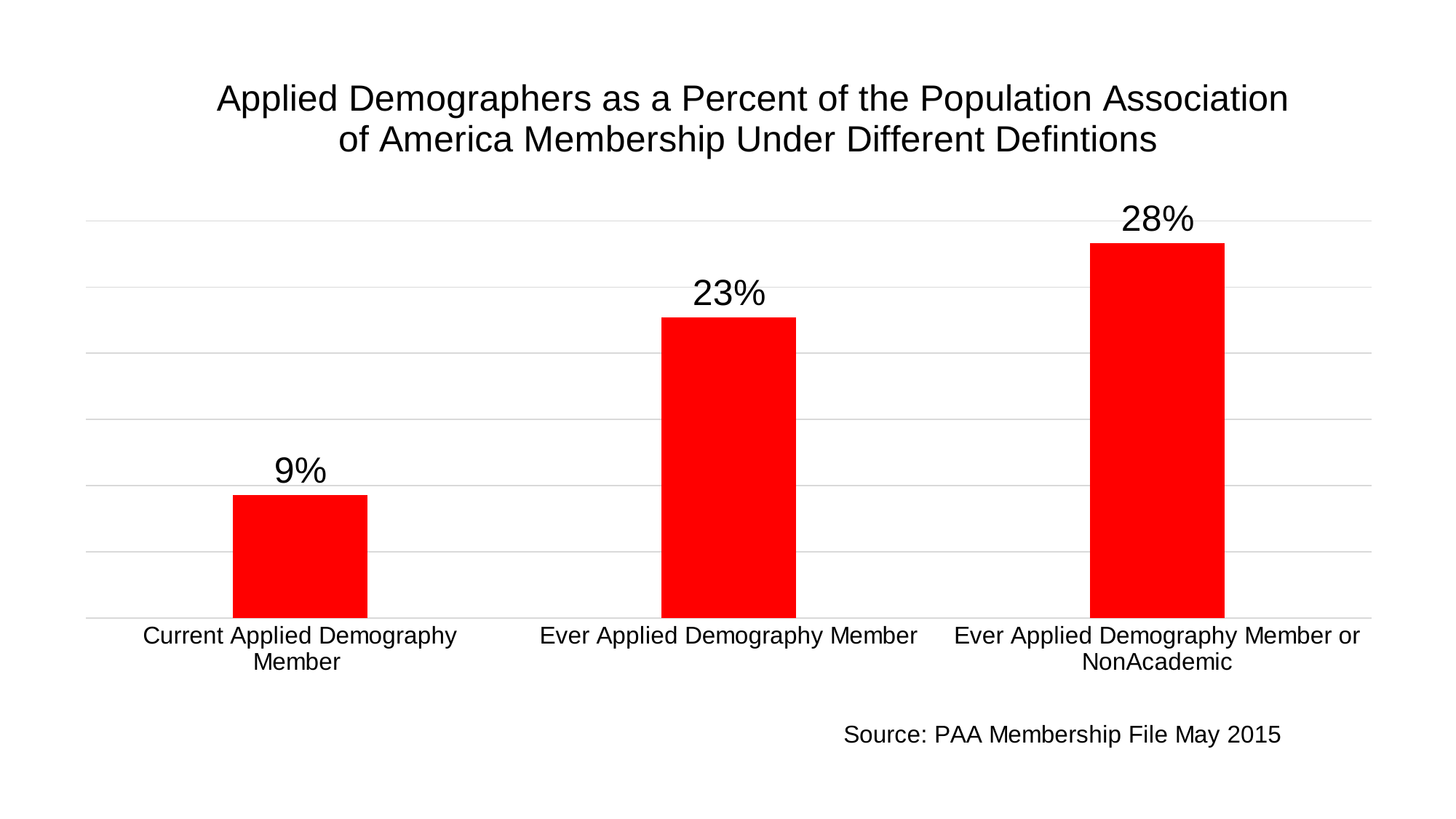
Which category has the lowest value? Current Applied Demography Member What is the value for Ever Applied Demography Member or NonAcademic? 28% What is the difference between the values for Ever Applied Demography Member and Ever Applied Demography Member or NonAcademic? 5% What is the value for Ever Applied Demography Member? 23% How many categories are shown in the chart? 3 Do the values rise or fall from left to right across the categories? Rise What kind of chart is shown on the slide? Bar chart What is the value for Current Applied Demography Member? 9% Which category has the highest value? Ever Applied Demography Member or NonAcademic What is the difference between the values for Ever Applied Demography Member or NonAcademic and Current Applied Demography Member? 19% Which is larger, the value for Ever Applied Demography Member or the value for Current Applied Demography Member? Ever Applied Demography Member What source is cited for the chart's data? PAA Membership File May 2015